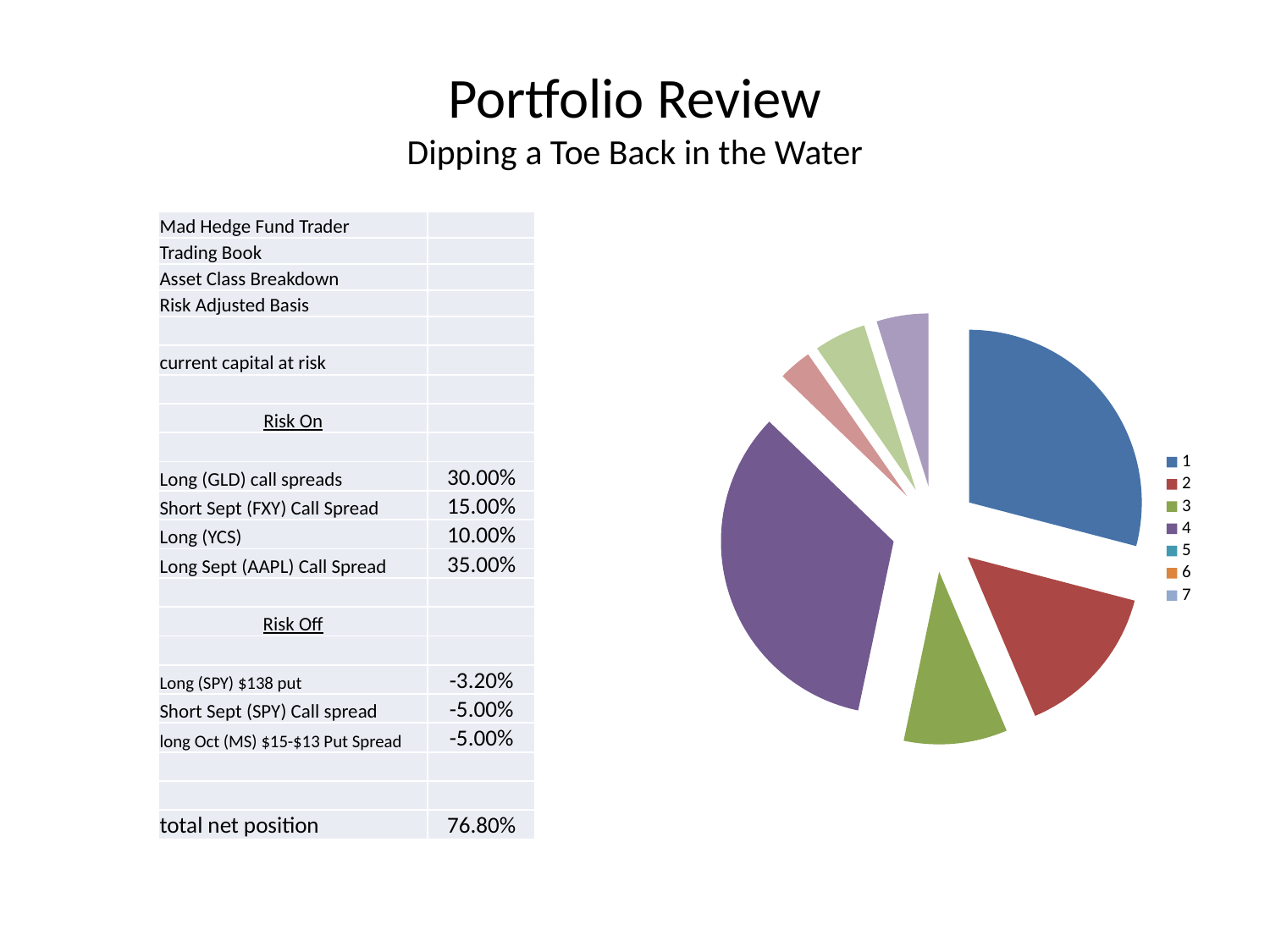
What kind of chart is shown on the slide? pie chart Which slice is larger in the pie chart, slice 3 or slice 1? 1 Which slice is larger in the pie chart, slice 4 or slice 3? 4 Which slice is larger in the pie chart, slice 1 or slice 2? 1 How many slices does the pie chart have? 7 What colour is slice 1 in the pie chart? blue On which side of the pie chart is the legend placed? right How many entries does the legend of the pie chart list? 7 Which slice of the pie chart is the largest? 4